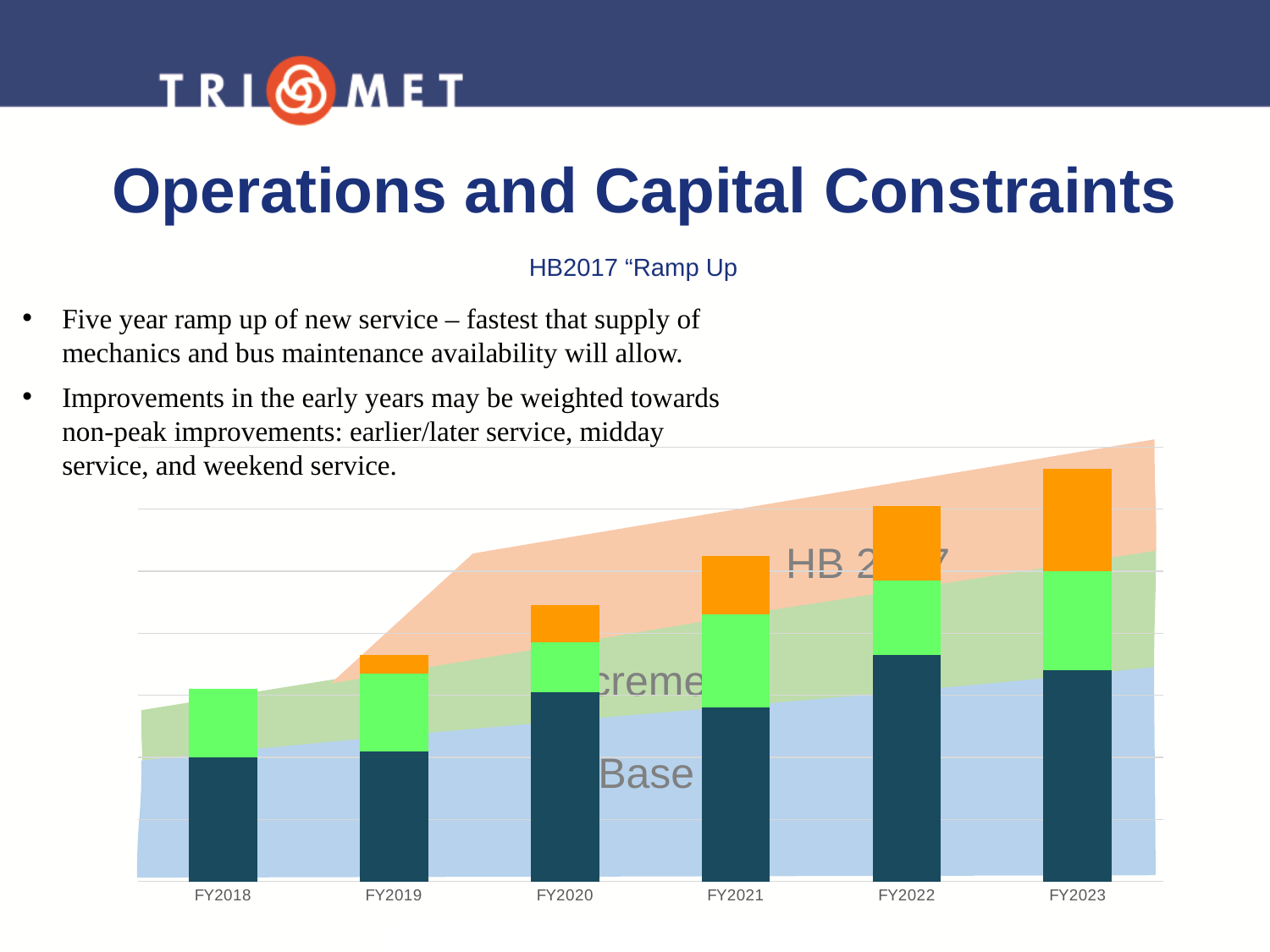
Do the stacked bar heights rise or fall from FY2018 to FY2023? Rise What label is shown on the lowest (blue) area of the chart? Base Which is the first fiscal year in which the bar includes an orange segment? FY2019 Which fiscal year has the shortest stacked bar? FY2018 Which stacked bar is taller, FY2020 or FY2022? FY2022 What is the last category label on the x axis of the chart? FY2023 What kind of chart is shown on the slide? Stacked bar chart What is the first category label on the x axis of the chart? FY2018 Which fiscal year has the tallest stacked bar? FY2023 Which stacked bar is taller, FY2021 or FY2019? FY2021 How many fiscal years are shown on the x axis of the chart? 6